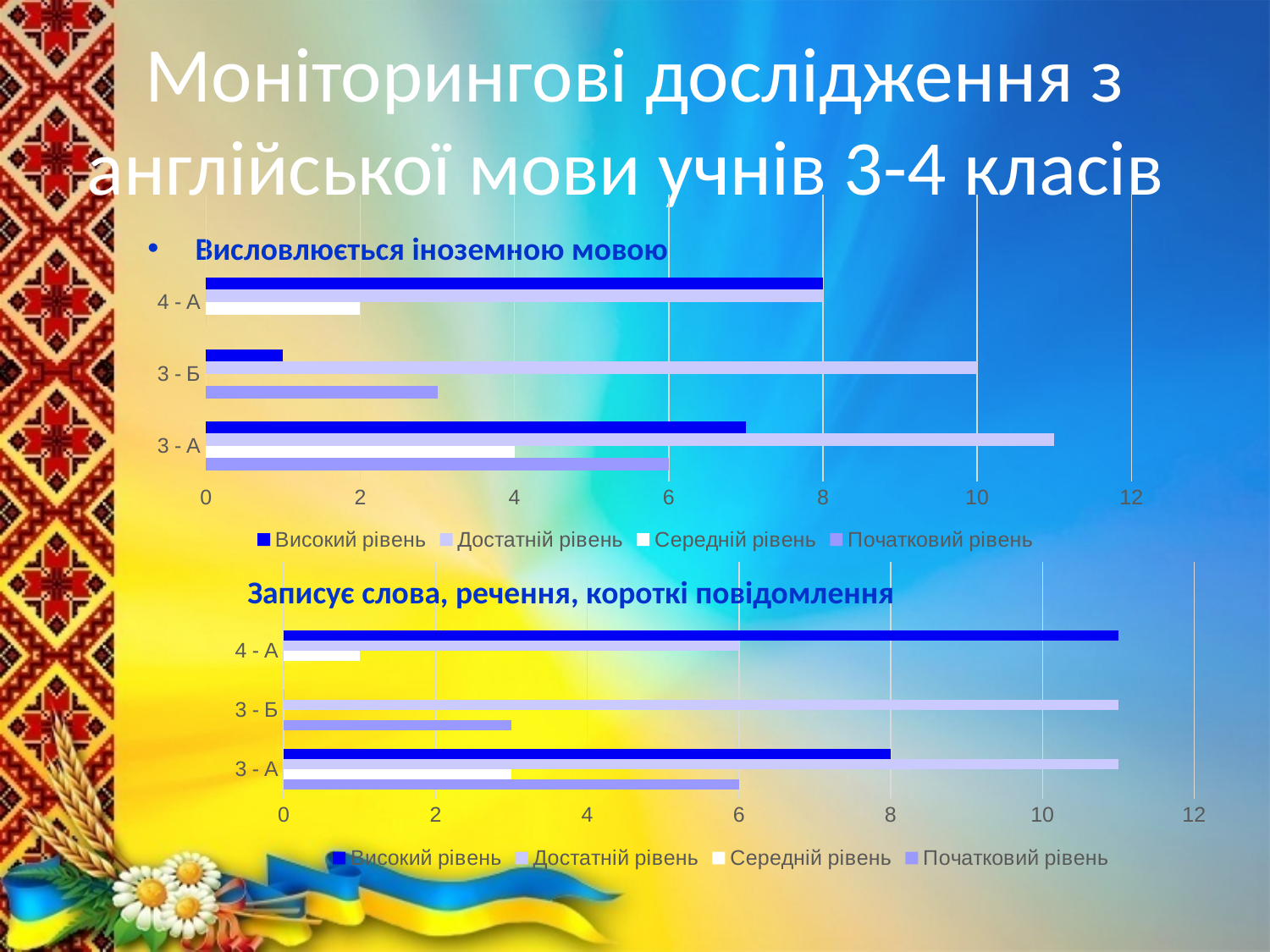
In the bottom chart "Записує слова, речення, короткі повідомлення", which is larger for 3 - А: Високий рівень or Достатній рівень? Достатній рівень In the bottom chart "Записує слова, речення, короткі повідомлення", is the value of Високий рівень for 4 - А greater or less than 10? greater In the top chart "Висловлюється іноземною мовою", which category has the highest value for Високий рівень? 4 - А How many categories are shown on the y axis of the bottom chart "Записує слова, речення, короткі повідомлення"? 3 In the bottom chart "Записує слова, речення, короткі повідомлення", which is larger: Високий рівень for 4 - А or Високий рівень for 3 - А? 4 - А In the top chart "Висловлюється іноземною мовою", is the value of Високий рівень for 3 - Б greater or less than 2? less How many series does the legend of the top chart "Висловлюється іноземною мовою" list? 4 What is the title of the bottom chart on the slide? Записує слова, речення, короткі повідомлення In the bottom chart "Записує слова, речення, короткі повідомлення", is the value of Середній рівень for 4 - А greater or less than 2? less In the top chart "Висловлюється іноземною мовою", which category has the lowest value for Високий рівень? 3 - Б What kind of chart is the top chart titled "Висловлюється іноземною мовою"? bar chart